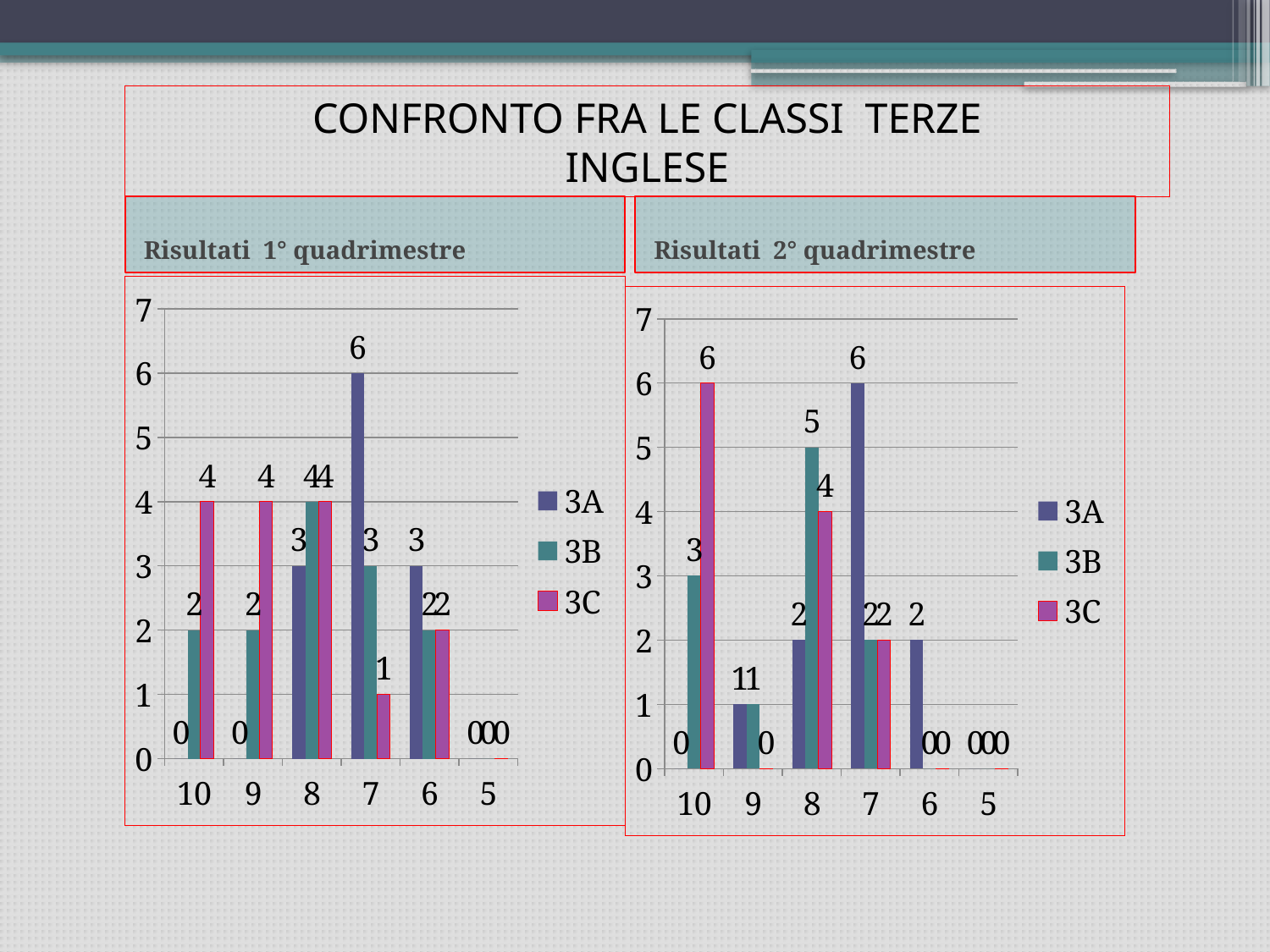
In the 'Risultati 2° quadrimestre' chart, what is the value for 3C at grade 10? 6 What type of chart is the 'Risultati 2° quadrimestre' chart? Bar chart In the 'Risultati 2° quadrimestre' chart, what is the difference between 3C and 3B at grade 10? 3 In the 'Risultati 2° quadrimestre' chart, how many grade categories are shown on the x axis? 6 In the 'Risultati 2° quadrimestre' chart, which is larger at grade 8, 3B or 3C? 3B In the 'Risultati 1° quadrimestre' chart, which series is shown in purple with a red outline? 3C In the 'Risultati 1° quadrimestre' chart, what is the value for 3B at grade 8? 4 In the 'Risultati 1° quadrimestre' chart, how many series does the legend list? 3 In the 'Risultati 2° quadrimestre' chart, what is the value for 3B at grade 8? 5 In the 'Risultati 1° quadrimestre' chart, what is the difference between 3A and 3C at grade 7? 5 In the 'Risultati 1° quadrimestre' chart, what is the value for 3A at grade 7? 6 In the 'Risultati 1° quadrimestre' chart, which grade has the highest value for 3A? 7